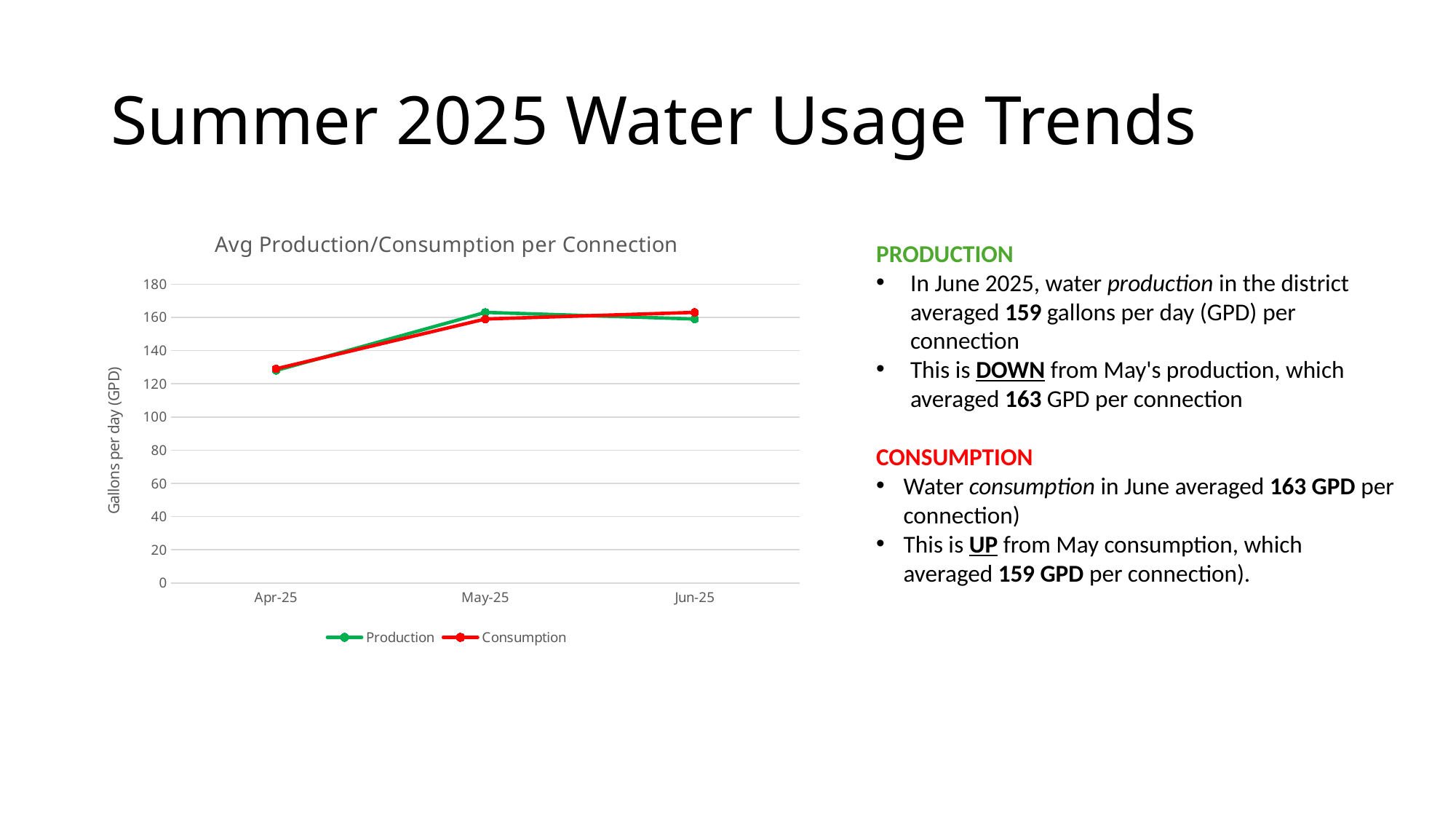
What kind of chart is shown on the slide? line chart Is the Production value for Apr-25 greater or less than 140? less Which is larger, the Production value for Apr-25 or for May-25? May-25 Does the Consumption line rise or fall from Apr-25 to Jun-25? rise What is the label on the vertical axis of the chart? Gallons per day (GPD) How many series does the chart legend list? 2 What is the title of the chart? Avg Production/Consumption per Connection Which month has the lowest Production value? Apr-25 Is the Consumption value for May-25 greater or less than 140? greater How many months are plotted on the x axis of the chart? 3 Is the Production value for Jun-25 greater or less than 180? less